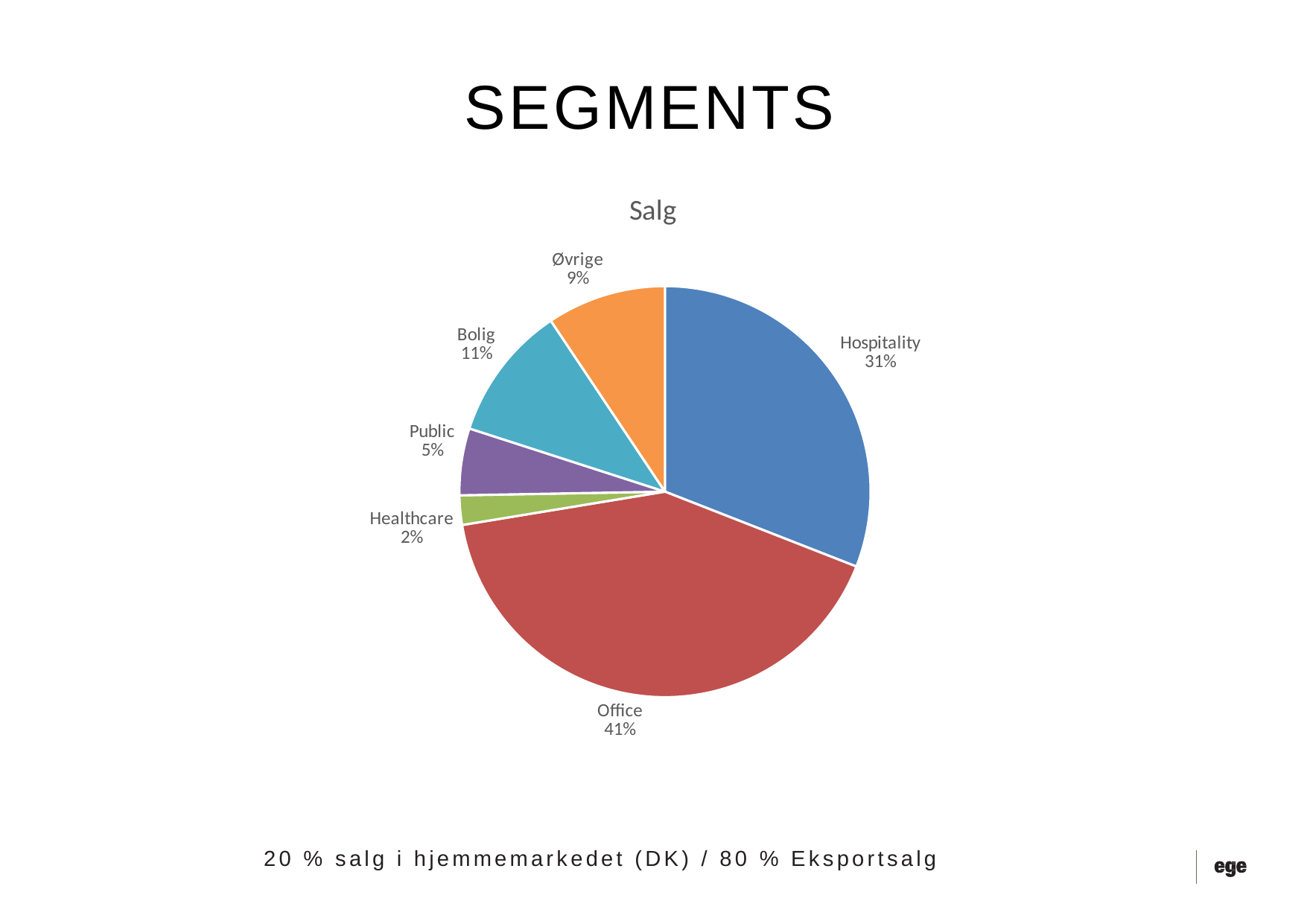
What is the value shown for Healthcare? 2% What is the difference in percentage points between Office and Hospitality? 10 What share of the pie does Hospitality have? 31% What is the title of the chart? Salg What share of the pie does Office have? 41% What colour is the Public slice? Purple How many segments are shown in the pie chart? 6 Which is larger, Bolig or Øvrige? Bolig What is the value shown for Bolig? 11% Which segment has the largest share of the pie? Office What kind of chart is shown on the slide? Pie chart Which segment has the smallest share of the pie? Healthcare